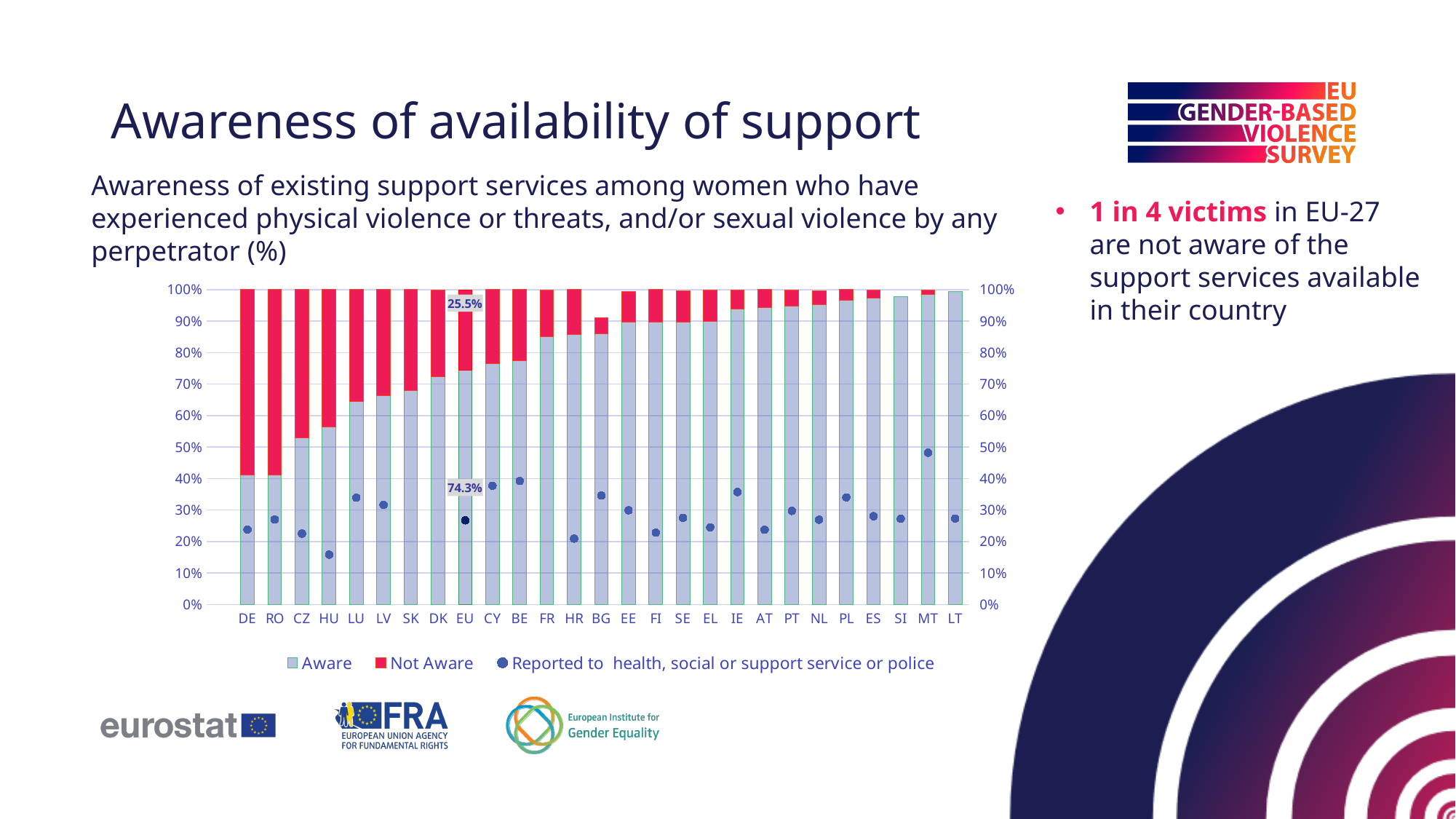
How many countries/categories are shown on the x axis of the chart? 27 What is the Not Aware value for EU in the chart? 25.5% Which country has the lowest value for 'Reported to health, social or support service or police'? HU Which has a larger Aware share, DE or FR? FR What is the Aware value for EU in the chart? 74.3% Is the Aware value for DE greater or less than 50%? less Does the Aware share rise or fall moving from left to right along the x axis? rise Which country has the highest value for 'Reported to health, social or support service or police'? MT What kind of chart is shown on the slide? Stacked bar chart with a dot series How many series does the chart legend list? 3 Is the 'Reported to health, social or support service or police' value for MT greater or less than 40%? greater What colour represents the 'Not Aware' series in the chart? Red